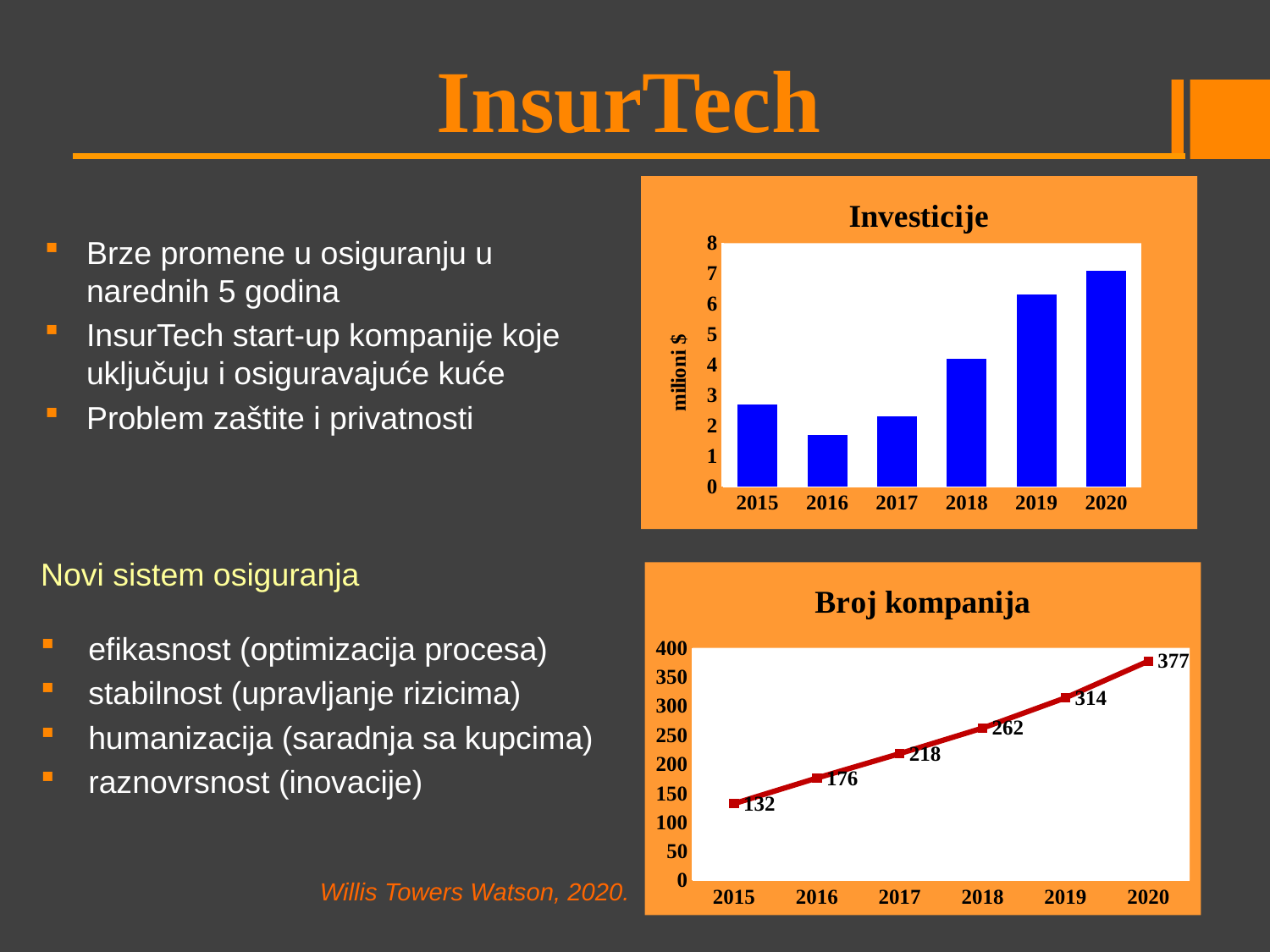
In the 'Broj kompanija' chart, what is the difference between the values for 2020 and 2015? 245 In the 'Broj kompanija' chart, do the values rise or fall from 2015 to 2020? rise In the 'Investicije' chart, which year has the lowest value? 2016 In the 'Investicije' chart, which year has the highest value? 2020 In the 'Broj kompanija' chart, what is the value for 2015? 132 In the 'Investicije' chart, which is larger, the value for 2018 or the value for 2017? 2018 What is the y-axis label of the 'Investicije' chart? milioni $ In the 'Investicije' chart, is the value for 2019 greater or less than 6? greater In the 'Broj kompanija' chart, what is the value for 2018? 262 In the 'Investicije' chart, is the value for 2016 greater or less than 2? less What type of chart is the 'Broj kompanija' chart? line chart What type of chart is the 'Investicije' chart? bar chart